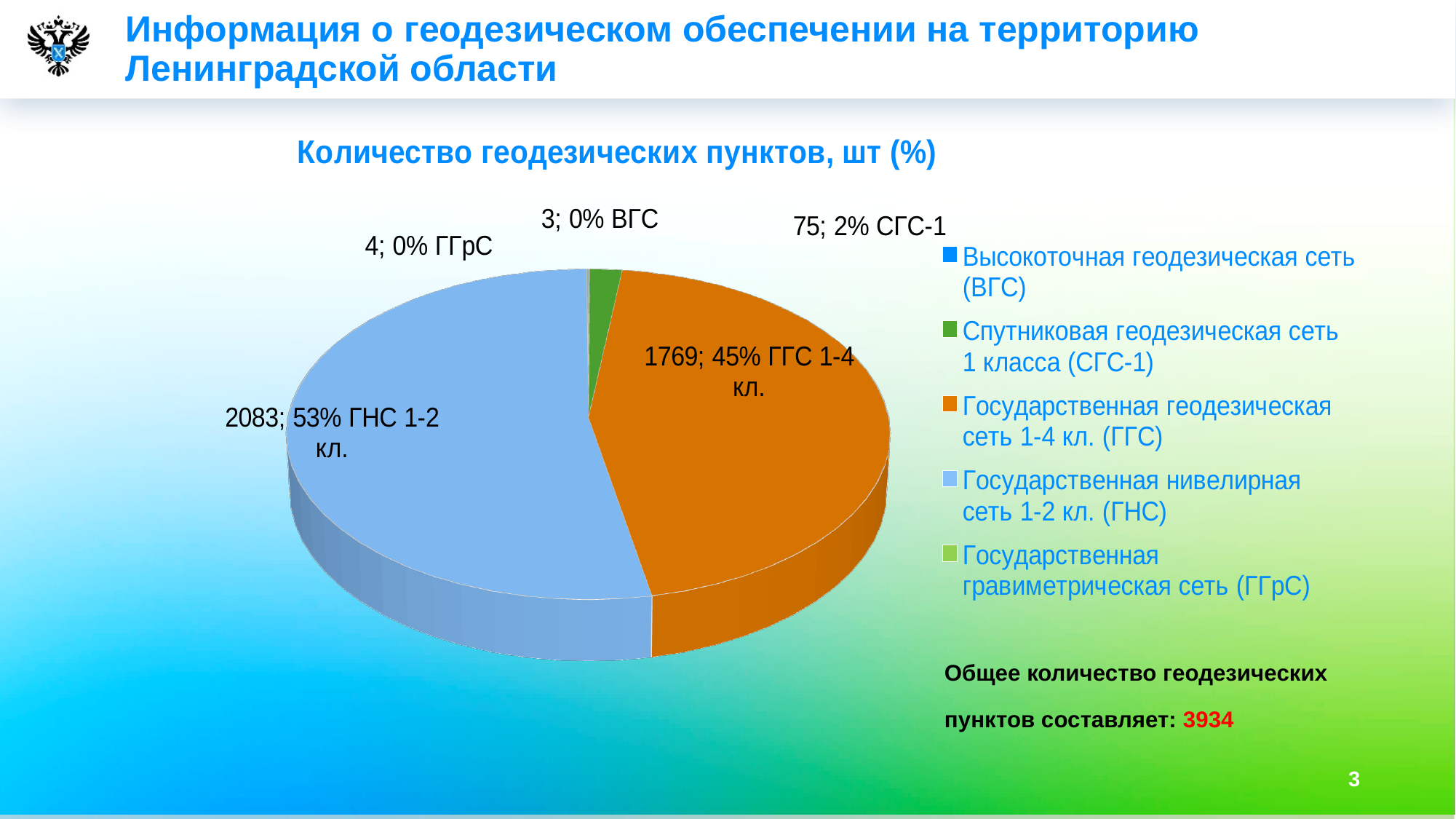
What share of the pie does СГС-1 represent? 2% How many entries does the legend list? 5 How many points does the chart show for ВГС? 3 How many points does the chart show for ГНС 1-2 кл.? 2083 What kind of chart is shown on the slide? Pie chart Which category has the largest number of points? ГНС 1-2 кл. What share of the pie does ГНС 1-2 кл. represent? 53% How many points does the chart show for СГС-1? 75 What is the difference in points between ГНС 1-2 кл. and ГГС 1-4 кл.? 314 What is the title of the chart? Количество геодезических пунктов, шт (%) How many points does the chart show for ГГС 1-4 кл.? 1769 Which category has the smallest number of points? ВГС